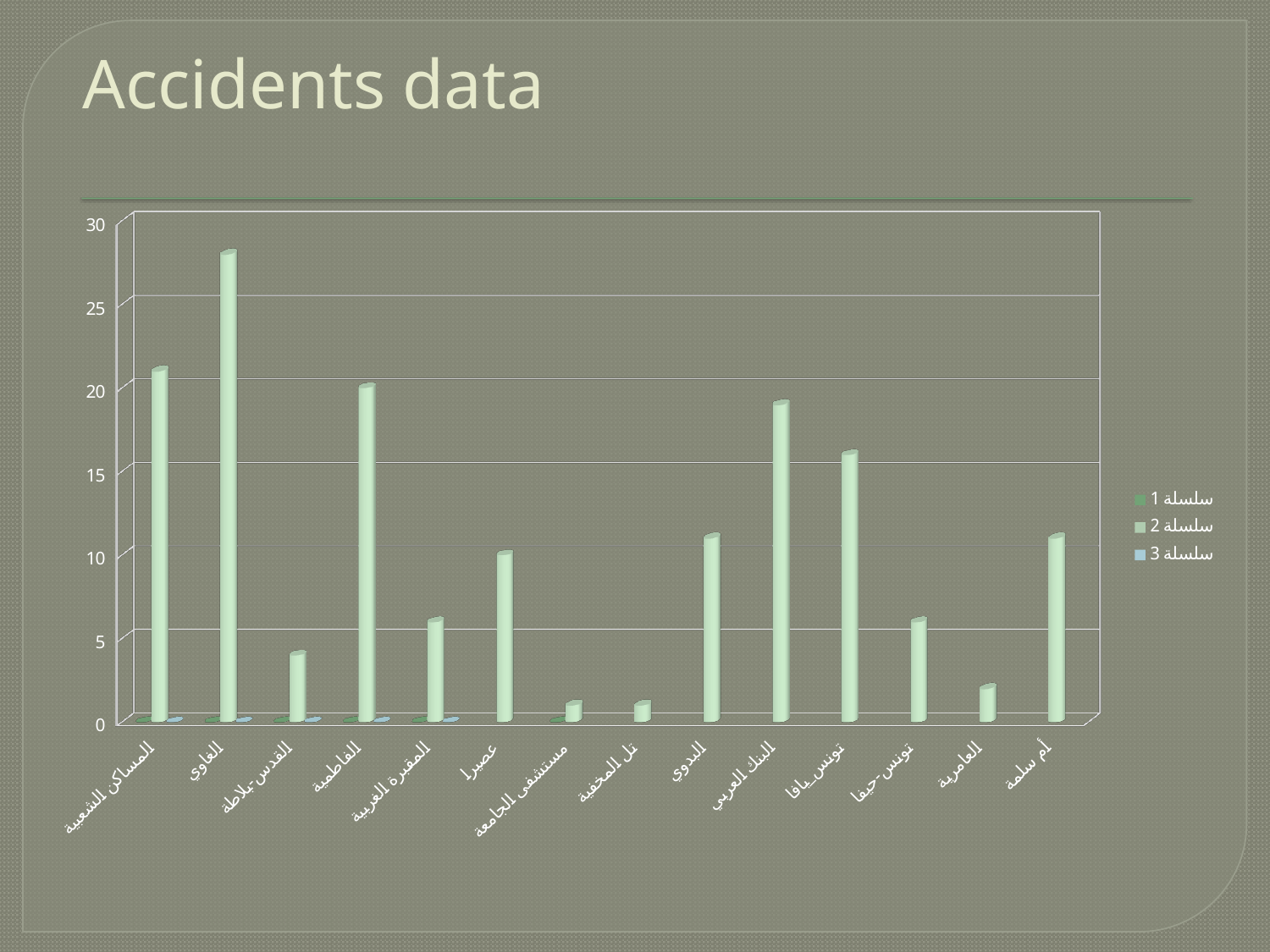
Is the value for البنك العربي greater or less than 15? greater Is the value for القدس بلاطة greater or less than 5? less What is the title of the slide containing the chart? Accidents data How many categories are shown on the x axis? 14 Which is larger, the value for الغاوي or the value for الفاطمية? الغاوي How many series does the legend list? 3 Which category has the highest bar? الغاوي Which is larger, the value for المساكن الشعبية or the value for البدوي? المساكن الشعبية What kind of chart is shown on the slide? bar chart Is the value for العامرية greater or less than 5? less What is the highest value shown on the vertical axis? 30